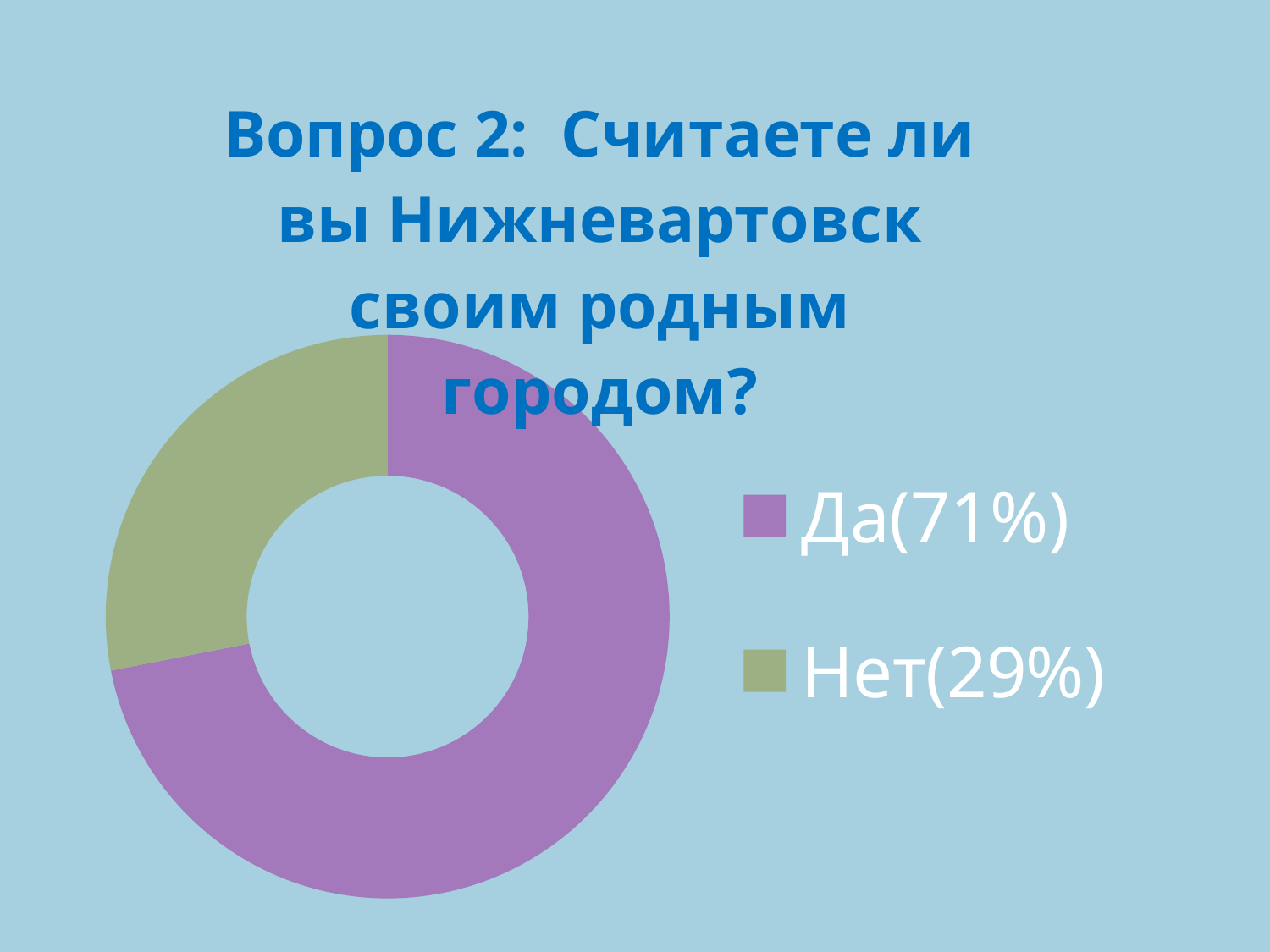
Which answer has the smallest share? Нет Which is larger, the share for "Да" or the share for "Нет"? Да Which answer has the largest share? Да What share of respondents answered "Да"? 71% How many entries does the legend list? 2 What is the title of the chart? Вопрос 2: Считаете ли вы Нижневартовск своим родным городом? What kind of chart is shown on the slide? Doughnut (pie) chart Is the share for "Да" greater or less than 50%? greater What colour represents "Нет" in the chart? Green What share of respondents answered "Нет"? 29% How many categories does the chart show? 2 What is the difference in percentage points between "Да" and "Нет"? 42